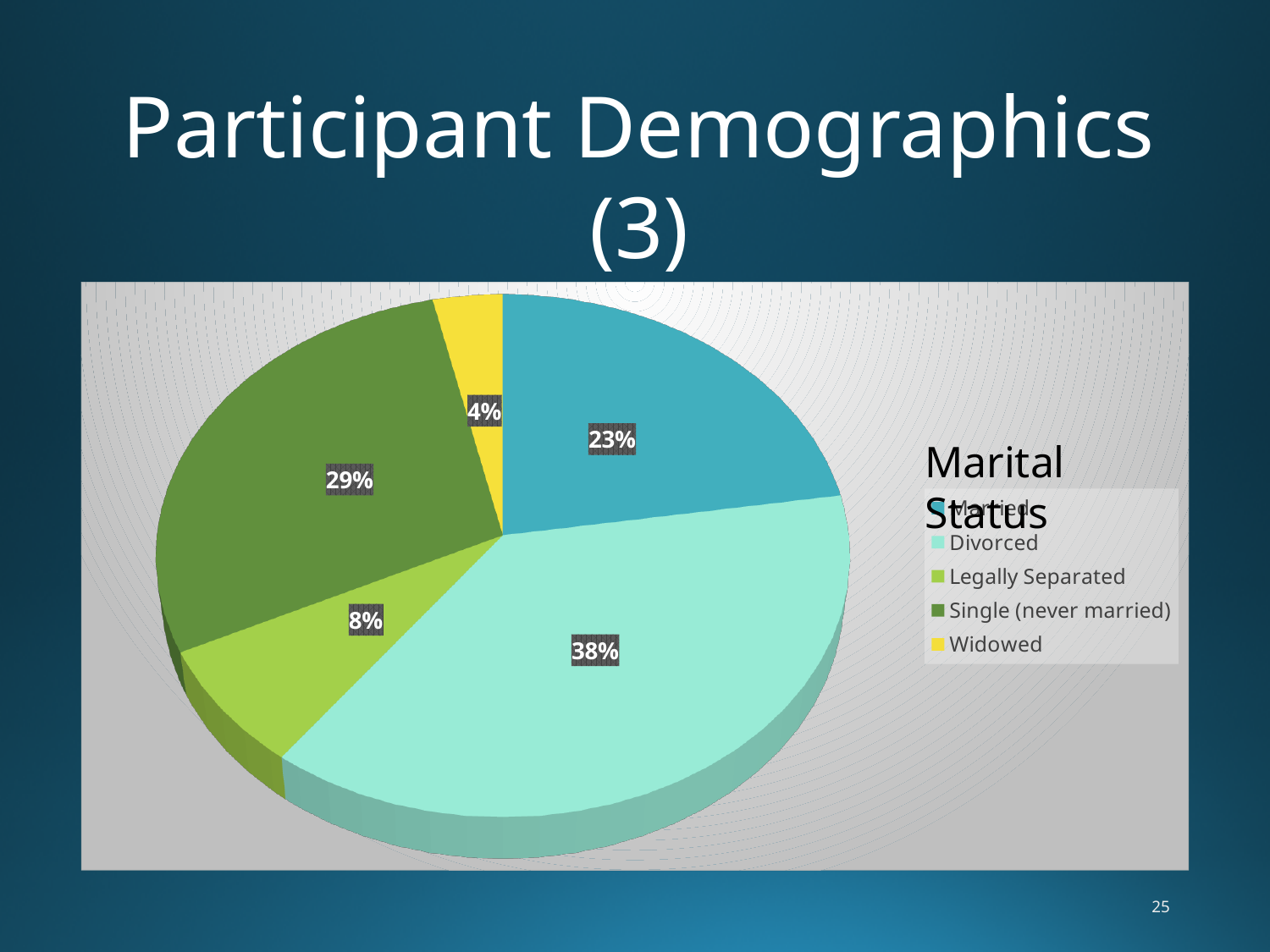
Which is larger, the Married share or the Single (never married) share? Single (never married) What percentage of participants are Widowed? 4% How many percentage points larger is the Divorced share than the Single (never married) share? 9% What percentage of participants are Legally Separated? 8% What type of chart is used to show marital status? Pie chart What percentage of participants are Divorced according to the Marital Status pie chart? 38% Which marital status category has the largest share of participants? Divorced How many marital status categories are shown in the pie chart? 5 What is the title of the chart on the slide? Marital Status What percentage of participants are Married? 23% What percentage of participants are Single (never married)? 29% Which marital status category has the smallest share of participants? Widowed